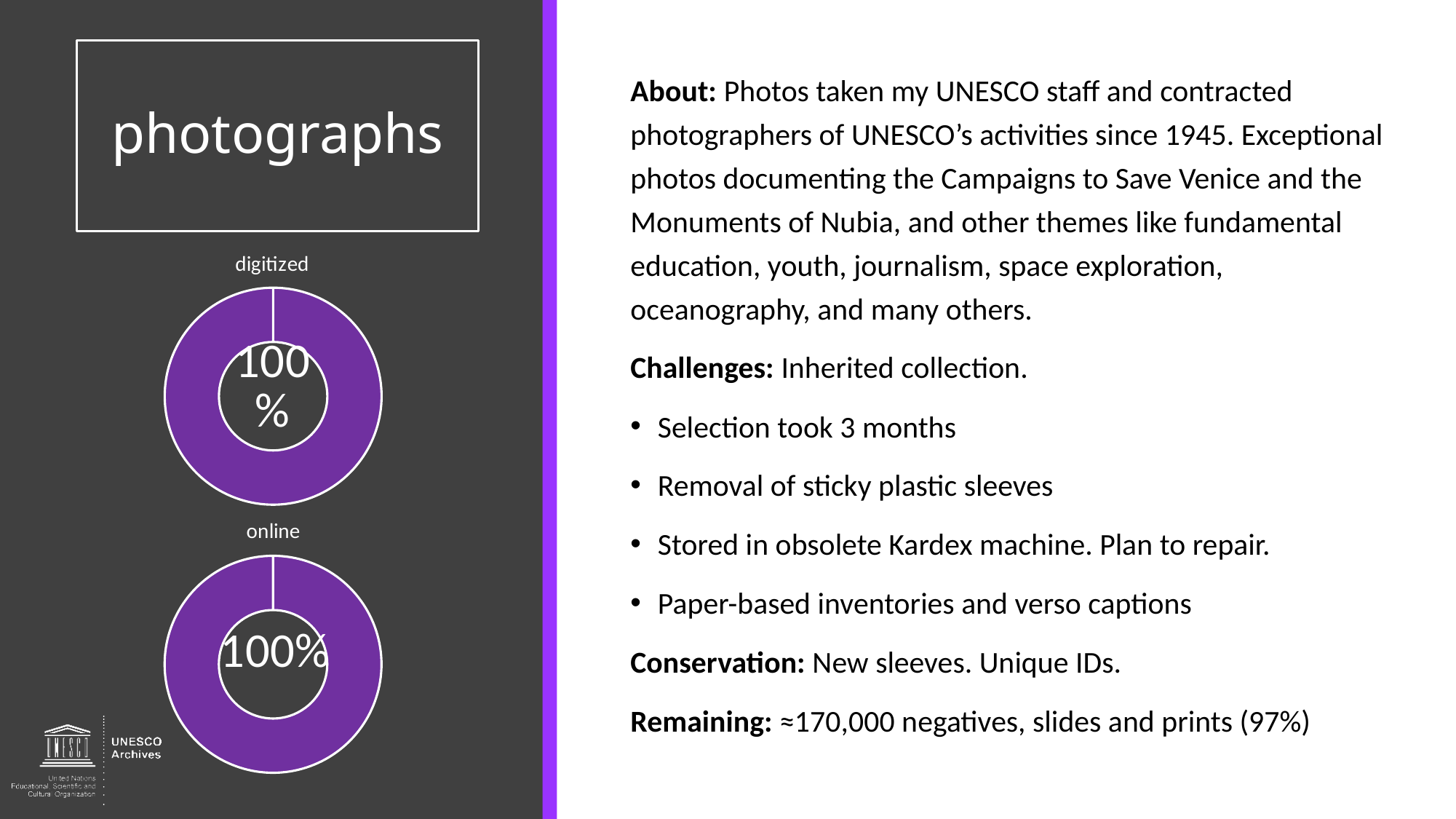
What is the difference between the value in the 'digitized' chart and the value in the 'online' chart? 0% What kind of chart is the 'digitized' chart? doughnut chart What is the title of the upper doughnut chart? digitized What share of the 'online' doughnut chart does the purple slice take up? 100% What share of the 'digitized' doughnut chart does the purple slice take up? 100% Is the value shown in the 'digitized' chart greater or less than 50%? greater Is the value shown in the 'online' chart greater or less than 50%? greater What is the title of the lower doughnut chart? online What value is shown in the centre of the 'online' chart? 100% How many doughnut charts are shown on the slide? 2 What kind of chart is the 'online' chart? doughnut chart What value is shown in the centre of the 'digitized' chart? 100%